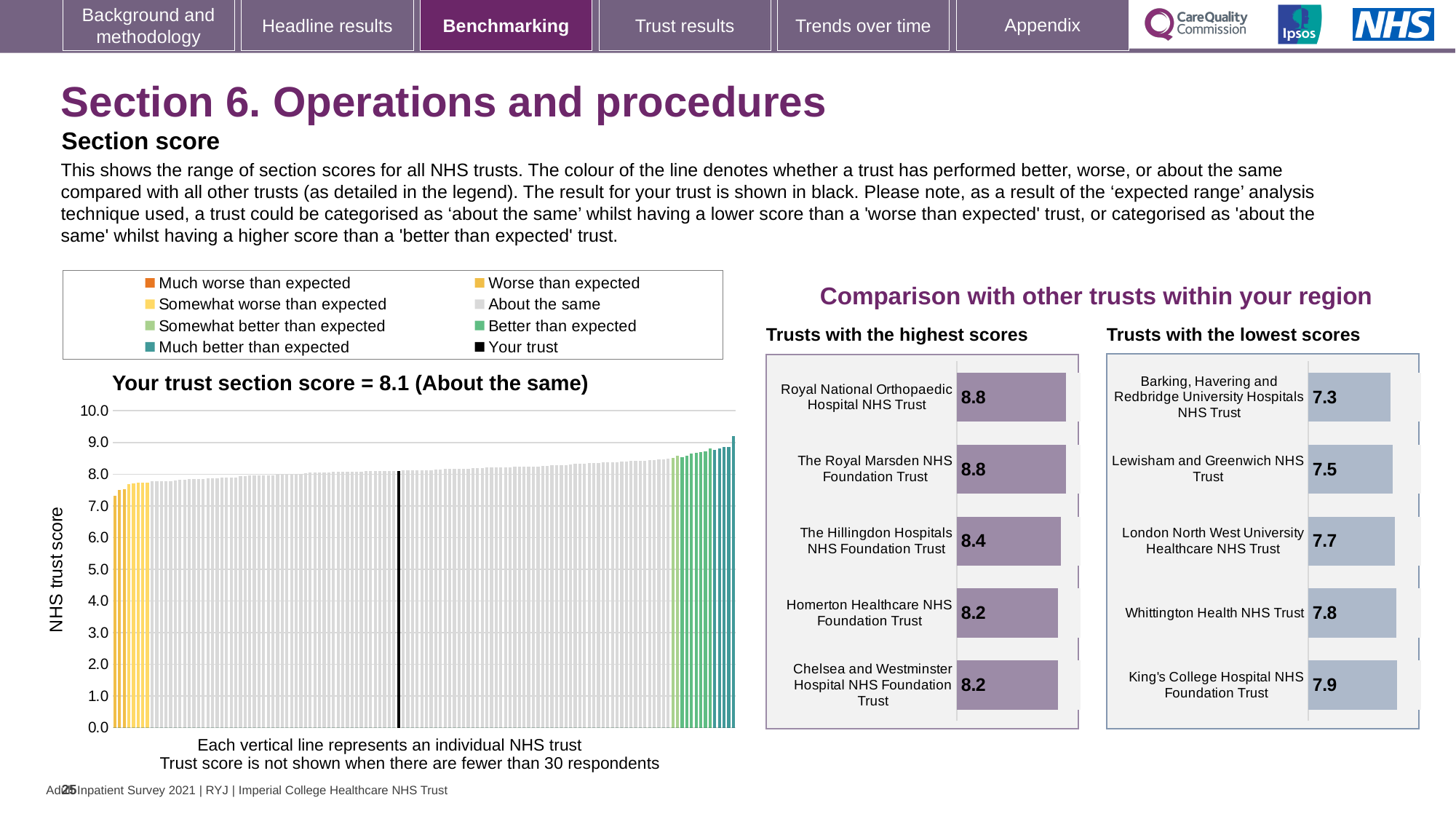
In the 'Your trust section score' chart, is the value of the tallest bar greater or less than 8.0? greater How many entries does the legend above the 'Your trust section score' chart list? 8 In the 'Your trust section score' chart, do the bar values rise or fall from left to right along the x axis? rise In the 'Trusts with the highest scores' chart, what is the score for The Hillingdon Hospitals NHS Foundation Trust? 8.4 In the 'Trusts with the highest scores' chart, what is the difference between the scores of Royal National Orthopaedic Hospital NHS Trust and The Hillingdon Hospitals NHS Foundation Trust? 0.4 What is the y-axis label of the 'Your trust section score' chart? NHS trust score What kind of chart is the 'Your trust section score' chart? bar chart In the 'Trusts with the lowest scores' chart, which trust has the lowest score? Barking, Havering and Redbridge University Hospitals NHS Trust In the 'Trusts with the highest scores' chart, how many trusts are shown? 5 In the 'Trusts with the lowest scores' chart, which has the larger score: Lewisham and Greenwich NHS Trust or Whittington Health NHS Trust? Whittington Health NHS Trust In the 'Your trust section score' chart, what is the section score for your trust? 8.1 In the 'Trusts with the lowest scores' chart, which trust has the highest score? King's College Hospital NHS Foundation Trust